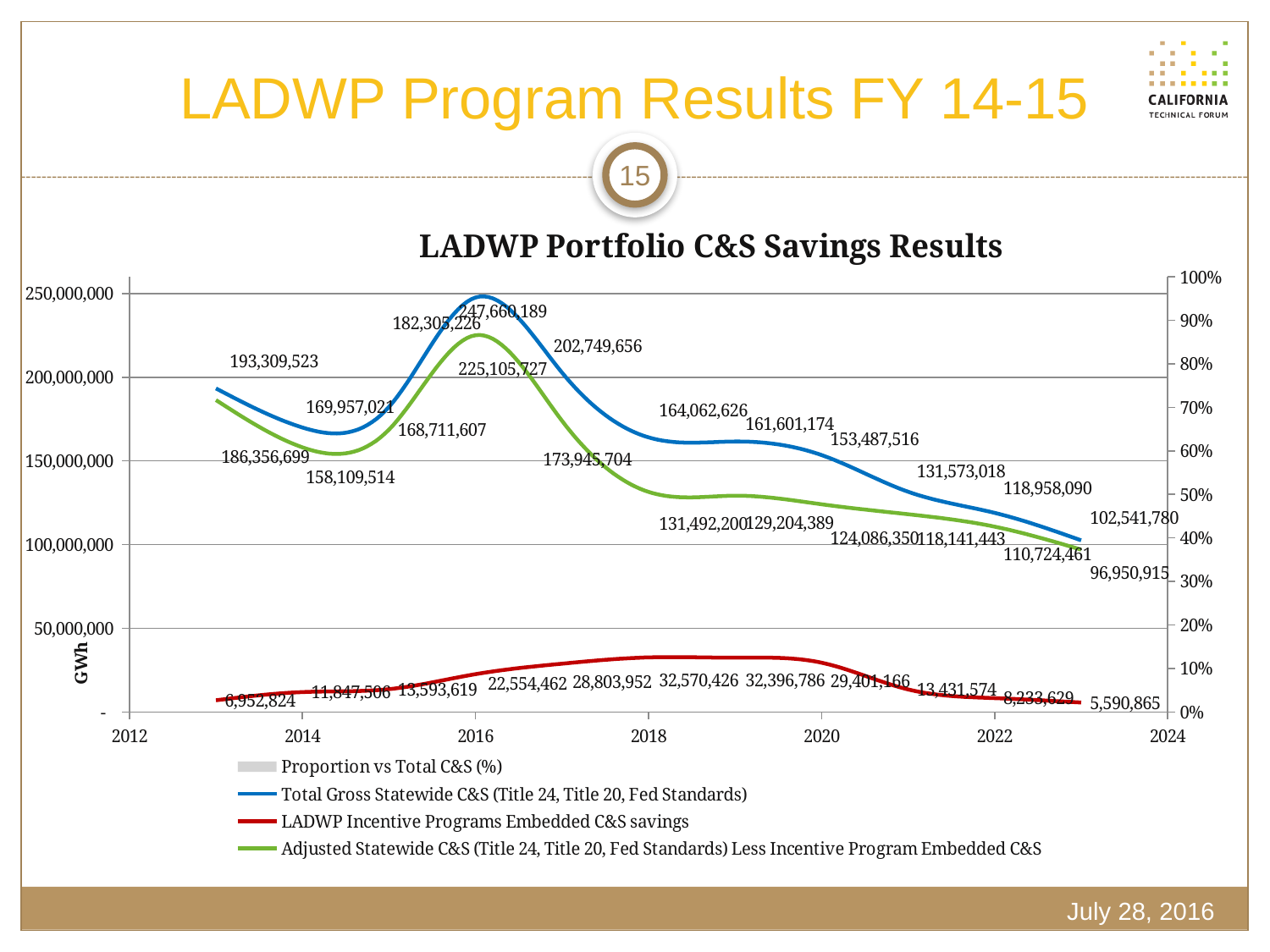
Does the Total Gross Statewide C&S line rise or fall from 2017 to 2023? fall What is the Adjusted Statewide C&S value in 2023? 96,950,915 What is the difference between the Total Gross Statewide C&S value and the Adjusted Statewide C&S value in 2016? 22,554,462 In which year is the Total Gross Statewide C&S value highest? 2016 What is the Total Gross Statewide C&S value in 2016? 247,660,189 What is the LADWP Incentive Programs Embedded C&S savings value in 2018? 32,570,426 What kind of chart is shown on the slide? line chart What is the title of the chart? LADWP Portfolio C&S Savings Results Is the LADWP Incentive Programs Embedded C&S savings value in 2019 greater or less than 50,000,000? less How many series does the legend list? 4 In which year is the LADWP Incentive Programs Embedded C&S savings value lowest? 2023 Which is larger, the Total Gross Statewide C&S value in 2013 or in 2023? 2013